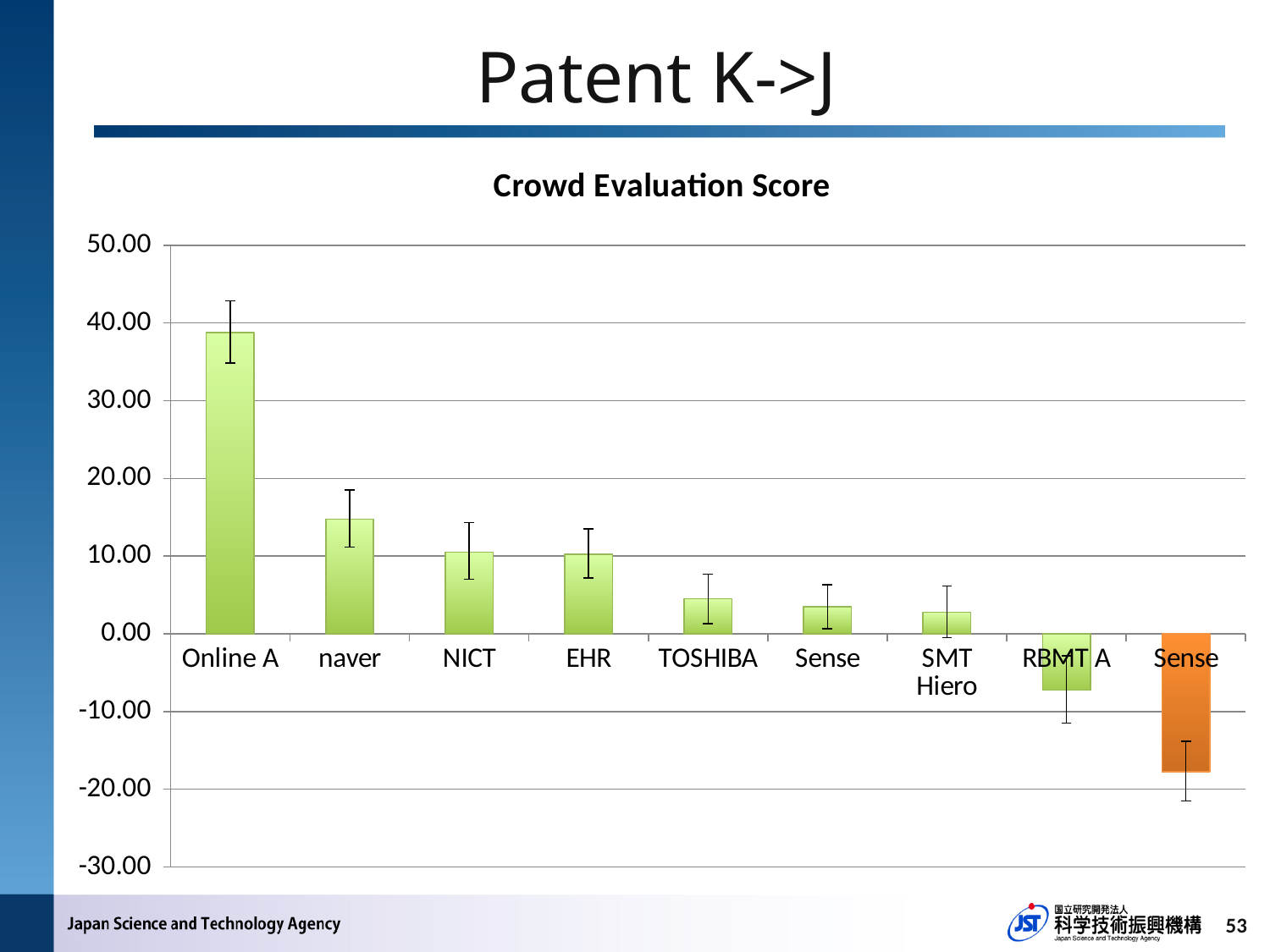
What is the title of the chart? Crowd Evaluation Score Which category has the highest Crowd Evaluation Score? Online A Which is larger, the value for Online A or the value for naver? Online A How many bars are plotted in the chart? 9 How many bars have a negative value? 2 Is the value for TOSHIBA greater or less than 10.00? less Is the value for naver greater or less than 20.00? less Do the values generally rise or fall from left to right along the x axis? fall Is the value for RBMT A greater or less than 0.00? less Which bar has the lowest Crowd Evaluation Score? the last bar (Sense, orange) What kind of chart is shown on the slide? bar chart